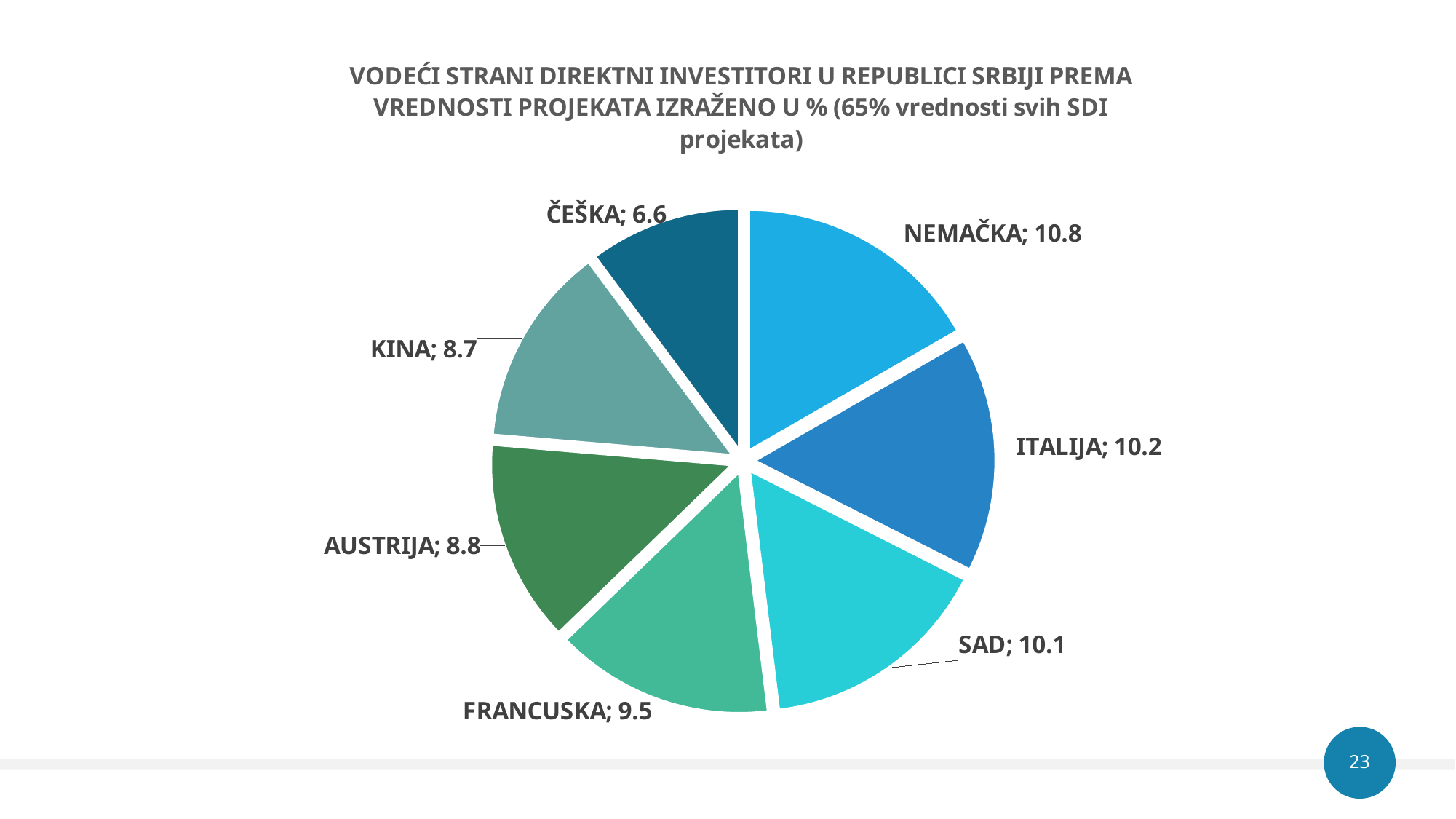
What is the difference between the values for ITALIJA and AUSTRIJA? 1.4 What is the value shown for SAD? 10.1 Which country has the smallest slice in the pie chart? ČEŠKA What is the value shown for KINA? 8.7 According to the chart title, what percentage of the value of all SDI projects do the leading investors account for? 65% What is the value shown for FRANCUSKA? 9.5 What is the value shown for NEMAČKA? 10.8 Which country has the largest slice in the pie chart? NEMAČKA Which has a larger value, FRANCUSKA or KINA? FRANCUSKA What kind of chart is shown on the slide? pie chart What is the difference between the values for NEMAČKA and ČEŠKA? 4.2 How many slices does the pie chart have? 7